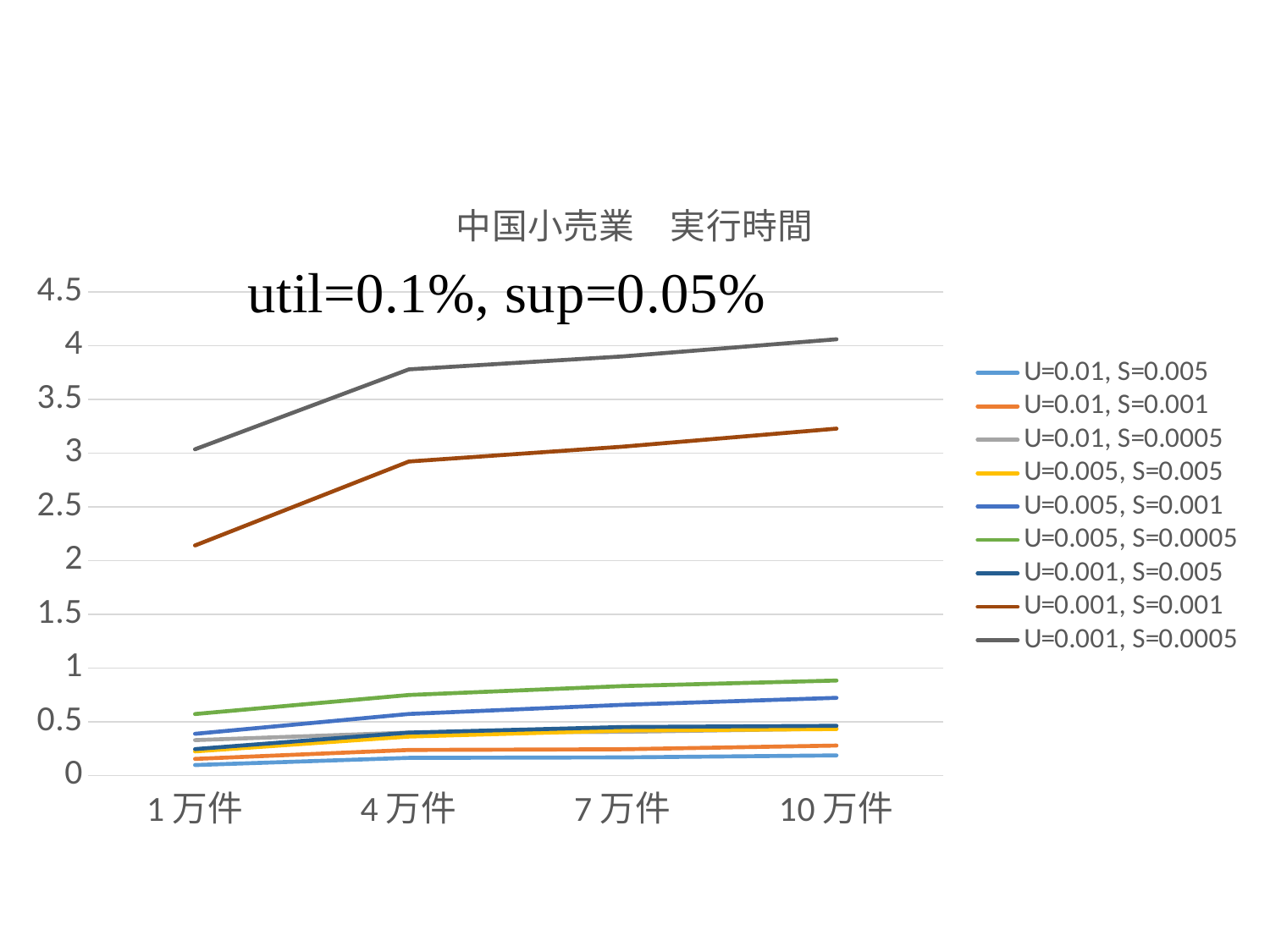
Is the value for U=0.001, S=0.001 at 10万件 greater or less than 3? greater What kind of chart is shown on the slide? line chart Is the value for U=0.01, S=0.005 at 10万件 greater or less than 0.5? less Which series has the highest value at 10万件? U=0.001, S=0.0005 At 10万件, which is larger: U=0.001, S=0.0005 or U=0.001, S=0.001? U=0.001, S=0.0005 What is the title of the chart? 中国小売業 実行時間 How many categories are on the x axis? 4 Does the U=0.001, S=0.0005 series rise or fall from 1万件 to 10万件? rise Is the value for U=0.005, S=0.0005 at 10万件 greater or less than 1? less How many series does the legend list? 9 Which series has the lowest value at 1万件? U=0.01, S=0.005